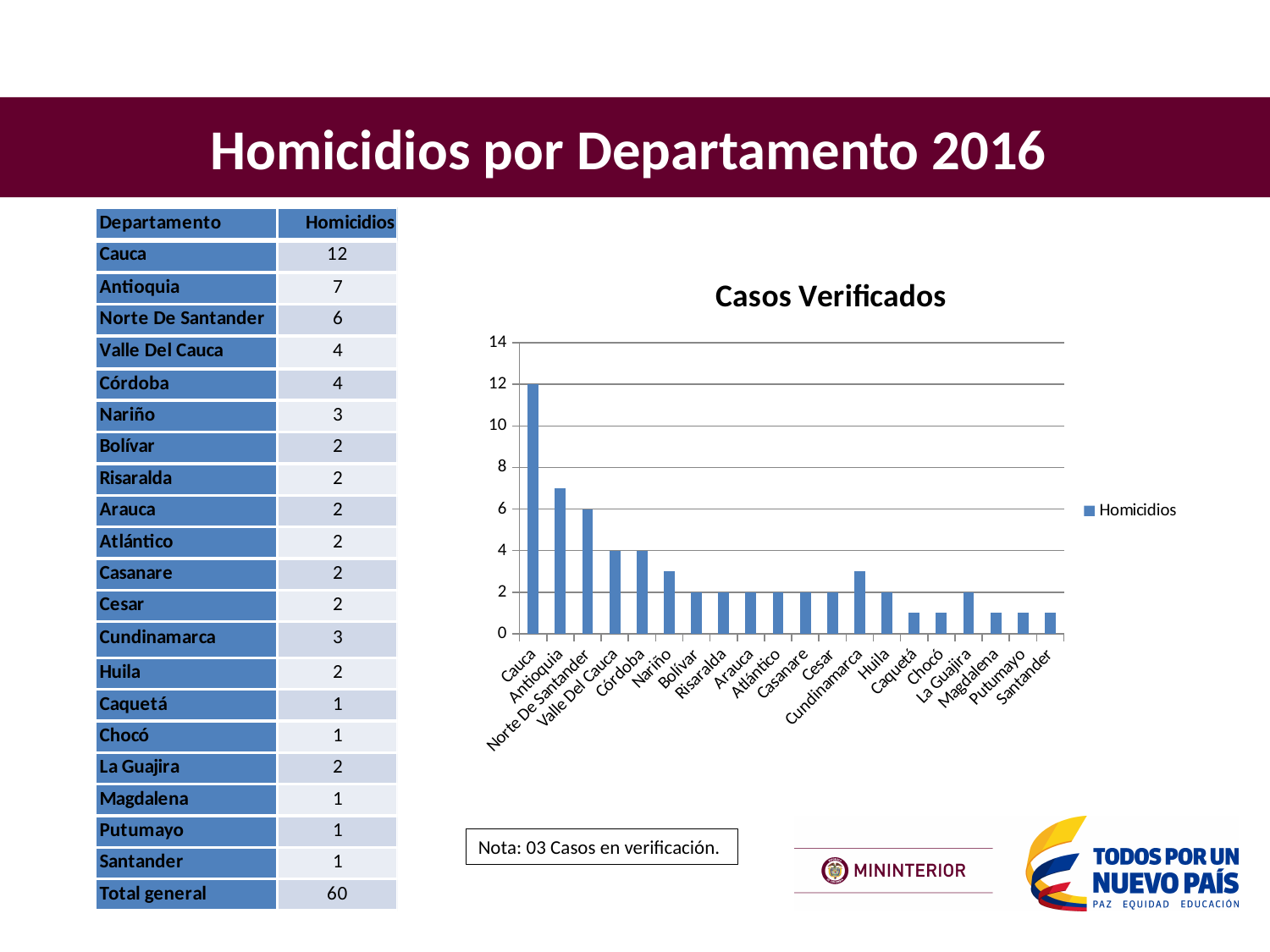
In the 'Casos Verificados' chart, what is the difference between the values for Cauca and Antioquia? 5 What is the name of the series shown in the legend of the 'Casos Verificados' chart? Homicidios In the 'Casos Verificados' chart, is the value for Cauca greater or less than 10? greater How many departments are shown on the x axis of the 'Casos Verificados' chart? 20 In the 'Casos Verificados' chart, what is the value for Norte De Santander? 6 In the 'Casos Verificados' chart, what is the value for Cundinamarca? 3 Which department has the highest value in the 'Casos Verificados' chart? Cauca In the 'Casos Verificados' chart, what is the value for Cauca? 12 In the 'Casos Verificados' chart, which is larger, the value for Norte De Santander or the value for Nariño? Norte De Santander What kind of chart is the 'Casos Verificados' chart? Bar chart In the 'Casos Verificados' chart, what is the value for Antioquia? 7 How many series does the legend of the 'Casos Verificados' chart list? 1